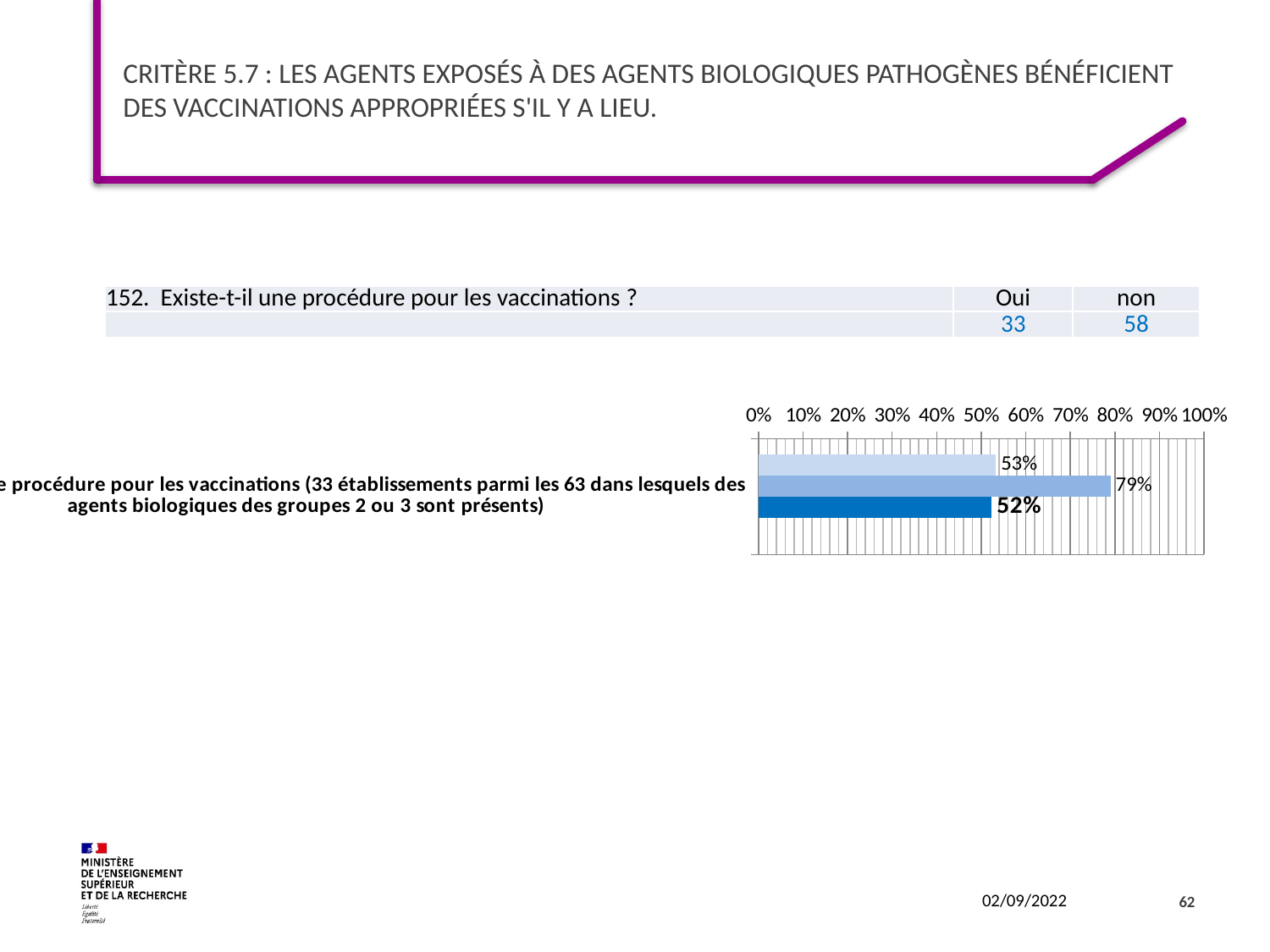
What is the highest value shown on the chart's horizontal axis? 100% What is the value shown on the bottom (dark blue) bar of the chart? 52% Is the value of the top bar greater or less than 60%? less What kind of chart is shown on the slide? bar chart What is the difference between the middle bar's value and the bottom bar's value? 27% Which bar has the lowest value in the chart: top, middle or bottom? bottom Which bar has the highest value in the chart: top, middle or bottom? middle Is the value of the middle bar greater or less than 70%? greater What is the value shown on the middle bar of the chart? 79% What is the difference between the top bar's value and the bottom bar's value? 1% What is the value shown on the top (lightest blue) bar of the chart? 53% How many bars are plotted in the chart? 3